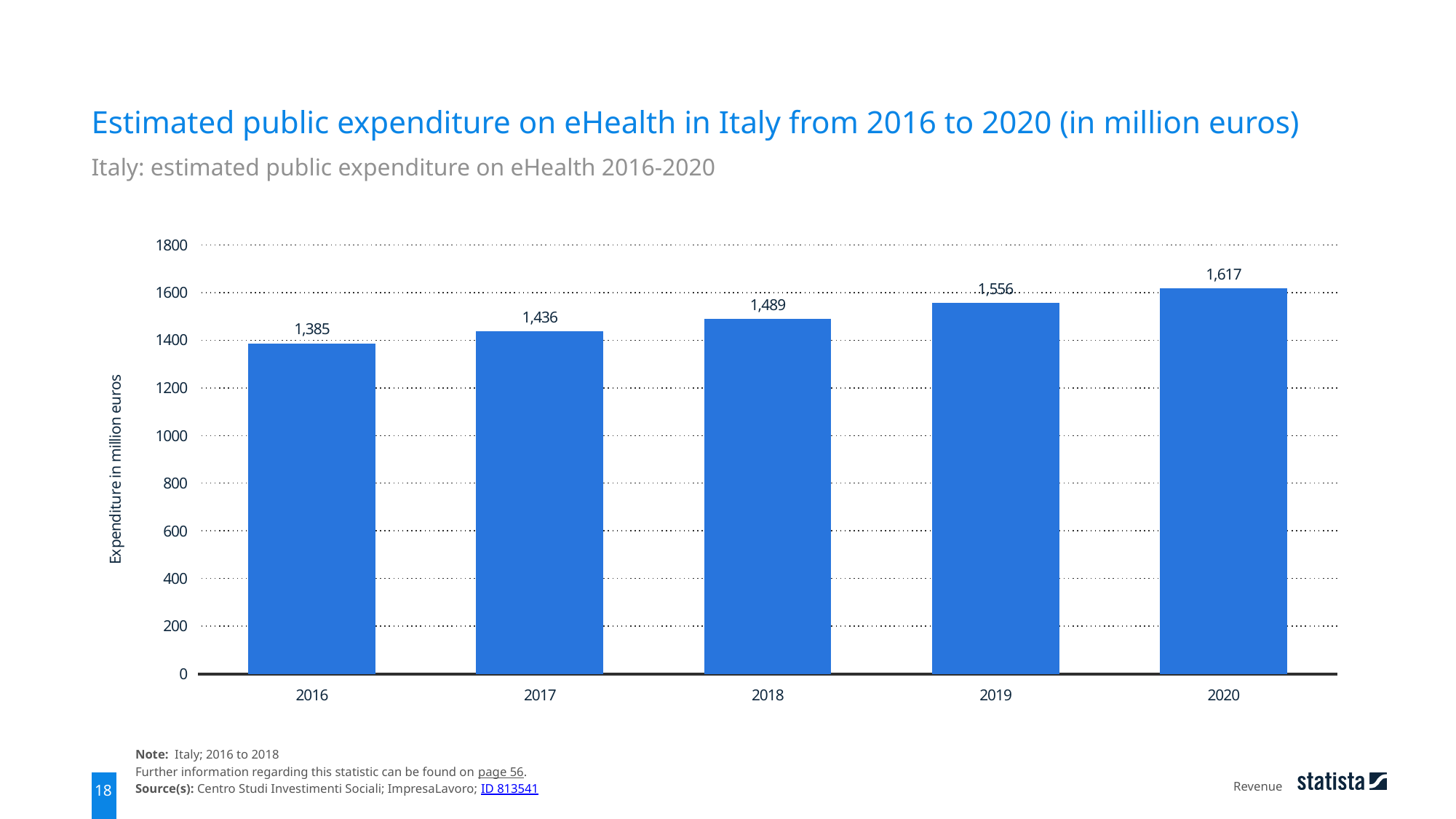
Which year has the lowest estimated public expenditure on eHealth? 2016 What is the estimated public expenditure on eHealth in Italy for 2016? 1,385 Which year has the highest estimated public expenditure on eHealth? 2020 How many years are shown in the chart? 5 What is the estimated public expenditure on eHealth in Italy for 2020? 1,617 What is the estimated public expenditure on eHealth in Italy for 2018? 1,489 What kind of chart is shown on the slide? Bar chart Do the estimated eHealth expenditure values rise or fall from 2016 to 2020? Rise Which year has a larger estimated eHealth expenditure, 2017 or 2019? 2019 Is the estimated eHealth expenditure for 2019 greater or less than 1400? greater What is the difference in estimated eHealth expenditure between 2019 and 2018? 67 What is the difference in estimated eHealth expenditure between 2020 and 2016? 232